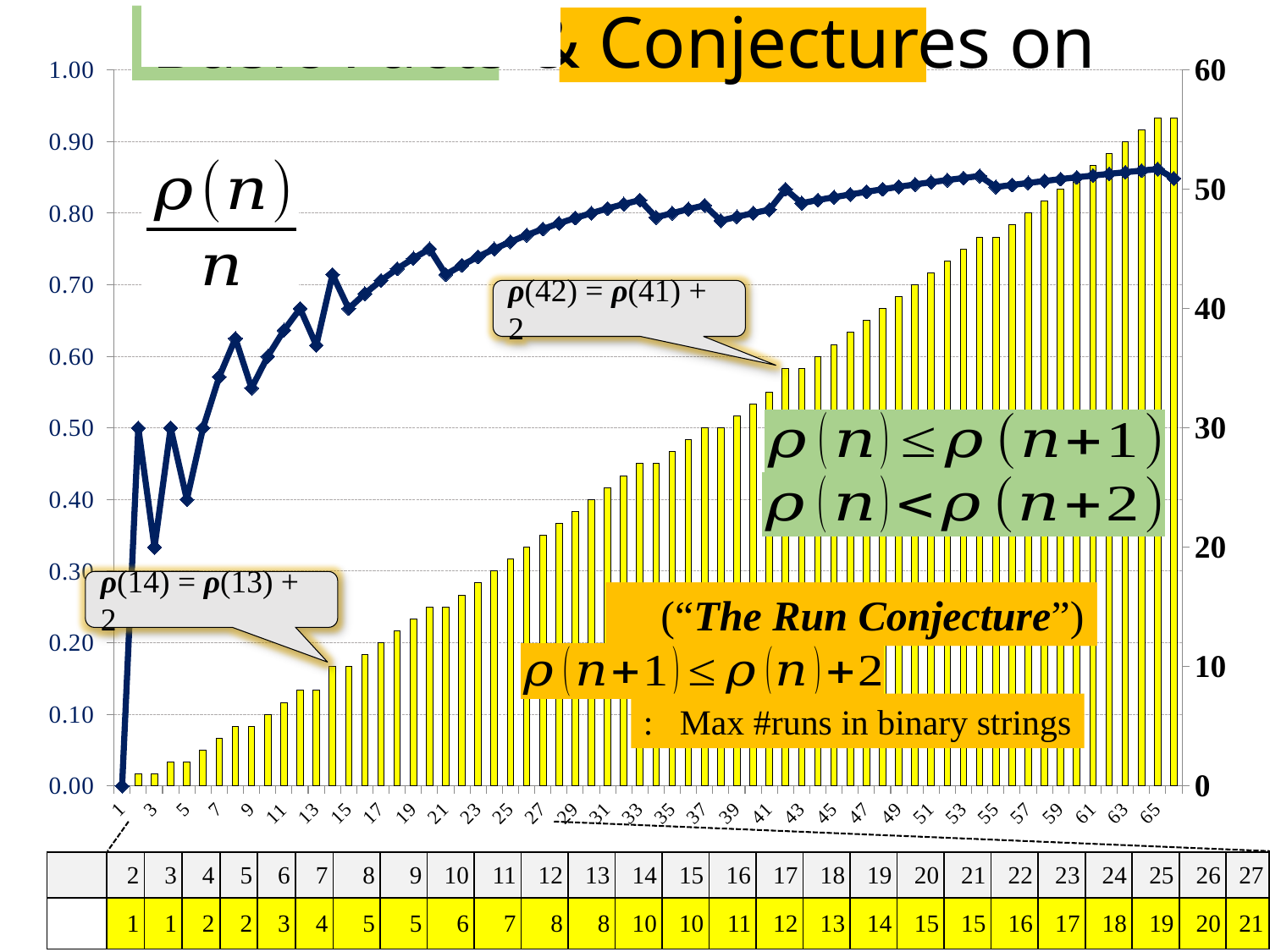
What kind of chart is shown on the slide? A combined bar and line chart Do the yellow bars generally rise or fall as n increases along the x axis? Rise Is the height of the bar at n = 42 greater or less than 30 on the right-hand axis? greater What is the value of the line series (ρ(n)/n) at n = 2? 0.50 Which is larger: the line value (ρ(n)/n) at n = 3 or at n = 4? n = 4 Is the value of the line series (ρ(n)/n) at n = 3 greater or less than 0.40? less Is the value of the line series (ρ(n)/n) at n = 65 greater or less than 0.80? greater At which n does the line series (ρ(n)/n) reach its lowest value? n = 1 Which bar is the tallest in the chart? The last two bars, at n = 65 and n = 66, are tied for tallest What does the callout pointing at the bar for n = 42 say? ρ(42) = ρ(41) + 2 What is the value of the line series (ρ(n)/n) at n = 1? 0.00